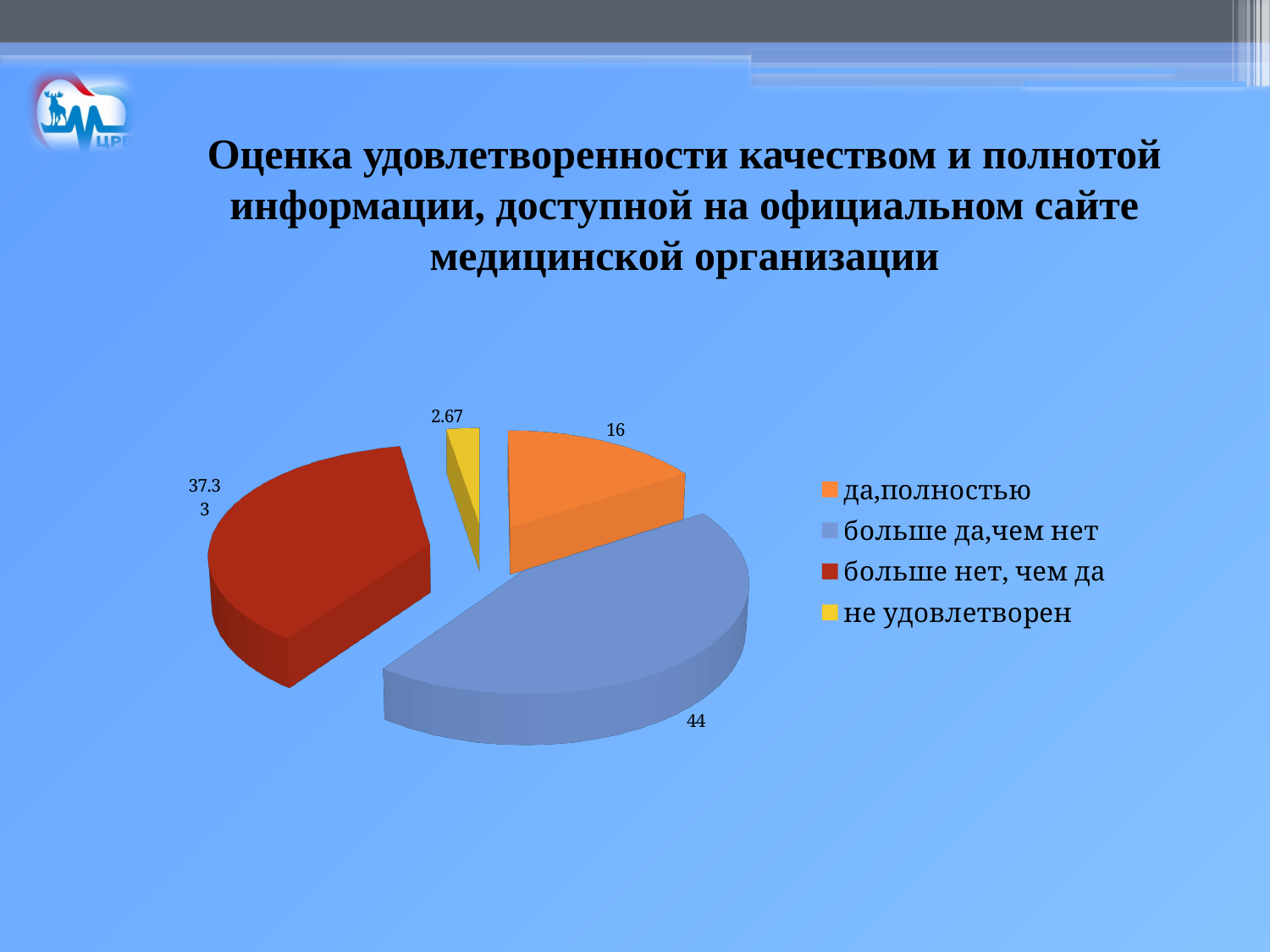
What is the value for the slice "не удовлетворен"? 2.67 How many slices does the pie chart have? 4 Which category has the smallest slice of the pie? не удовлетворен What is the value for the slice "да,полностью"? 16 What kind of chart is shown on the slide? pie chart What is the value for the slice "больше да,чем нет"? 44 Which category has the largest slice of the pie? больше да,чем нет How many entries does the legend list? 4 What colour is the slice for "не удовлетворен"? yellow Which is larger: the value for "больше нет, чем да" or the value for "да,полностью"? больше нет, чем да What is the value for the slice "больше нет, чем да"? 37.33 What is the difference between the values for "больше да,чем нет" and "да,полностью"? 28